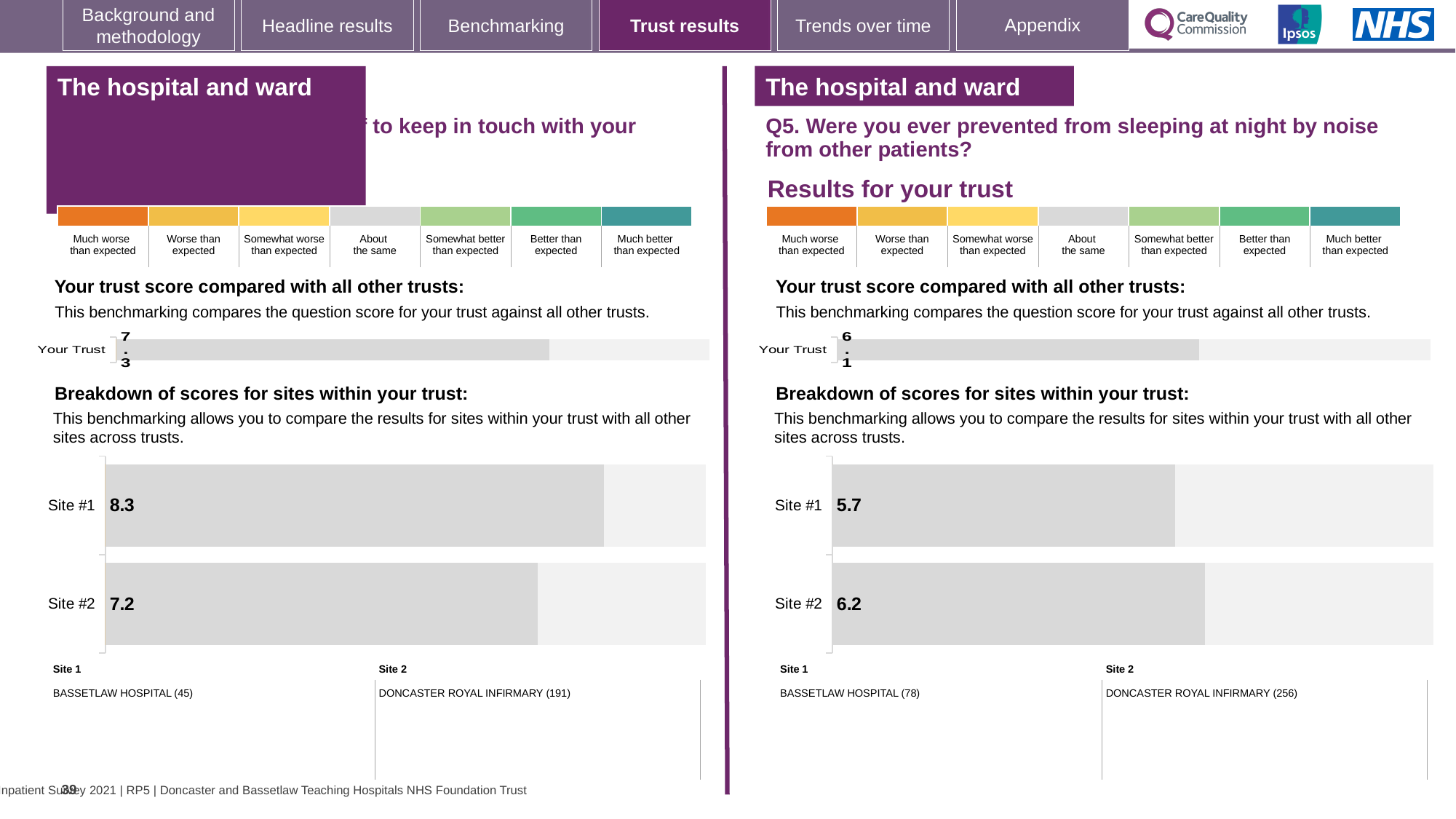
What type of chart is used for the site breakdown on the left-hand side of the slide? Bar chart On the left-hand site breakdown chart, which site has the highest score? Site #1 On the left-hand site breakdown chart, what is the score for Site #1? 8.3 On the left-hand site breakdown chart, what is the score for Site #2? 7.2 On the right-hand chart for Q5, which site has the higher score, Site #1 or Site #2? Site #2 On the left-hand side, what is the 'Your Trust' score shown in the trust benchmarking bar? 7.3 On the left-hand site breakdown chart, what is the difference between the Site #1 and Site #2 scores? 1.1 On the right-hand chart for Q5, what is the difference between the Site #2 and Site #1 scores? 0.5 On the right-hand side for Q5, what is the 'Your Trust' score shown in the trust benchmarking bar? 6.1 On the right-hand chart for Q5, what is the score for Site #2? 6.2 On the right-hand chart for Q5 (prevented from sleeping at night by noise from other patients), what is the score for Site #1? 5.7 How many sites are shown in the site breakdown chart on the right-hand side for Q5? 2